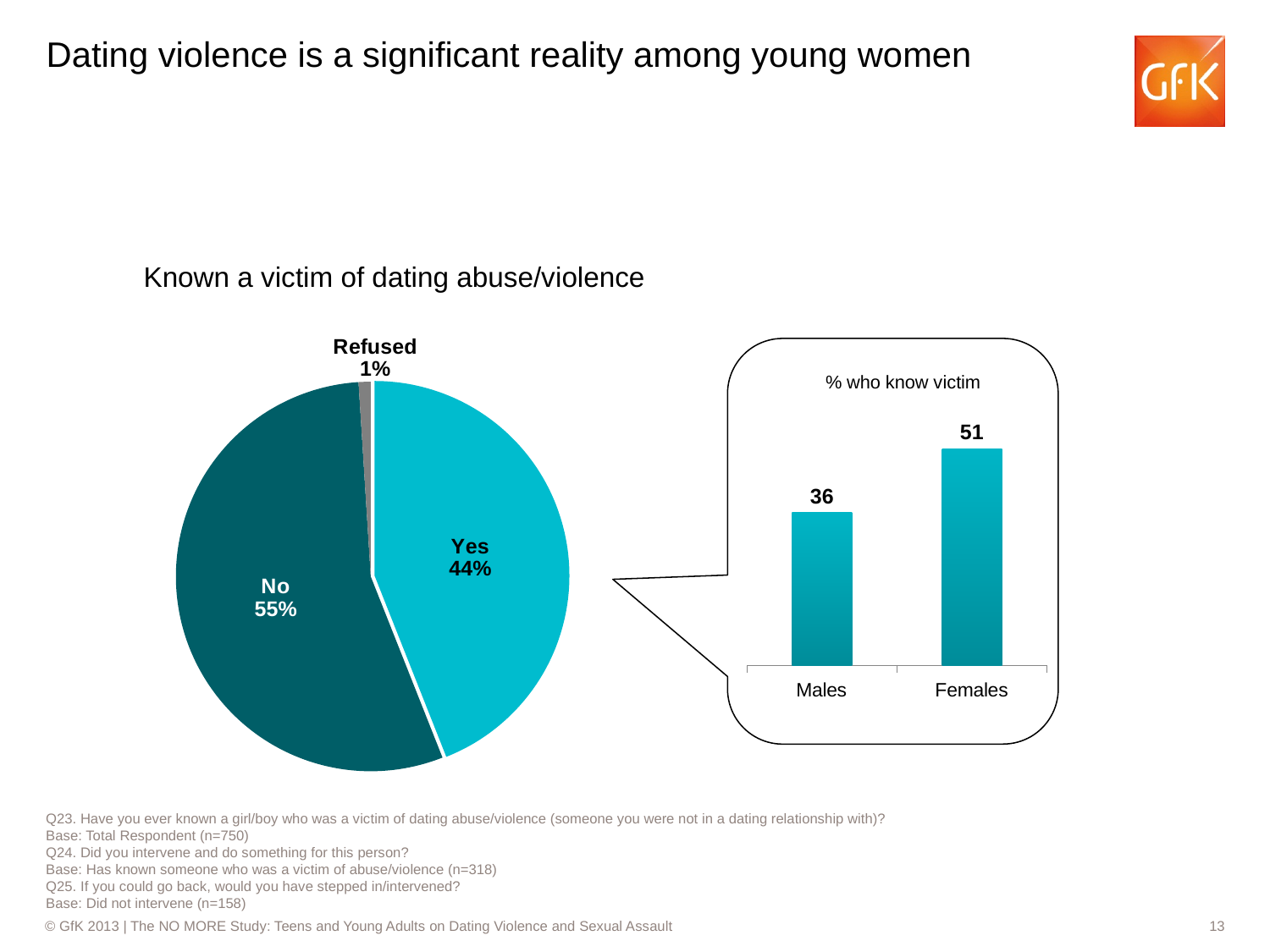
In the bar chart '% who know victim', what is the value for Males? 36 What kind of chart is the '% who know victim' chart on the right of the slide? Bar chart In the bar chart '% who know victim', what is the difference between the Females and Males values? 15 In the pie chart 'Known a victim of dating abuse/violence', which slice is the smallest? Refused In the pie chart 'Known a victim of dating abuse/violence', what is the difference in percentage points between No and Yes? 11 In the bar chart '% who know victim', what is the value for Females? 51 In the pie chart 'Known a victim of dating abuse/violence', how many slices are there? 3 In the pie chart 'Known a victim of dating abuse/violence', what percentage Refused? 1% In the pie chart 'Known a victim of dating abuse/violence', which slice is the largest? No In the pie chart 'Known a victim of dating abuse/violence', what percentage answered No? 55% In the bar chart '% who know victim', which category has the higher value, Males or Females? Females In the pie chart 'Known a victim of dating abuse/violence', what percentage answered Yes? 44%